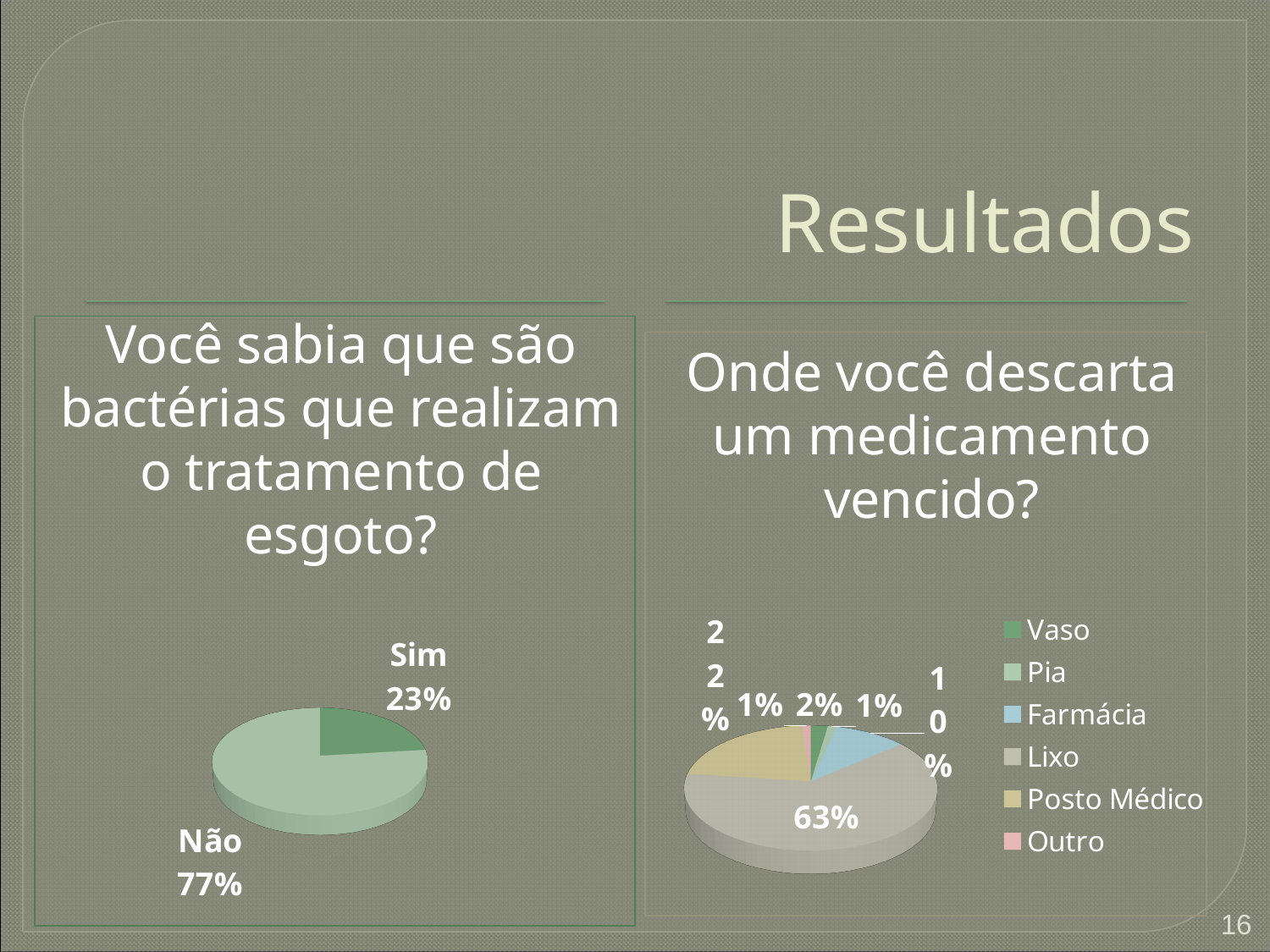
On the right chart ("Onde você descarta um medicamento vencido?"), what percentage is shown for "Posto Médico"? 22% On the left chart ("Você sabia que são bactérias que realizam o tratamento de esgoto?"), what percentage answered "Não"? 77% On the right chart, what is the difference in percentage points between "Lixo" and "Posto Médico"? 41 On the left chart, which answer has the larger share, "Sim" or "Não"? Não On the left chart ("Você sabia que são bactérias que realizam o tratamento de esgoto?"), what percentage answered "Sim"? 23% On the right chart ("Onde você descarta um medicamento vencido?"), what percentage is shown for "Farmácia"? 10% On the left chart, what is the difference in percentage points between "Não" and "Sim"? 54 How many categories does the legend of the right chart list? 6 On the right chart ("Onde você descarta um medicamento vencido?"), what percentage is shown for "Lixo"? 63% What type of chart is the left chart? Pie chart How many categories does the left chart show? 2 On the right chart, which category has the largest share? Lixo